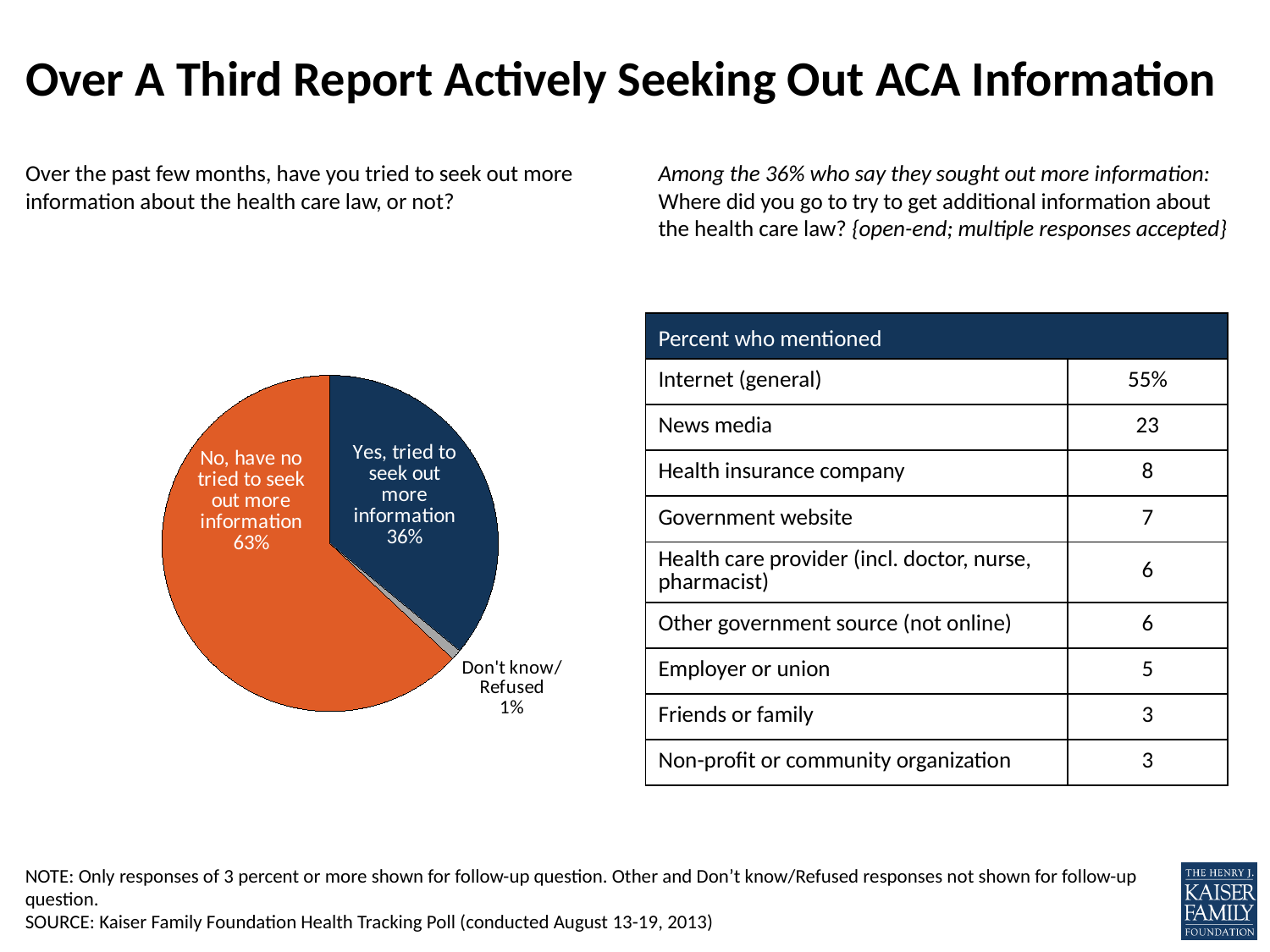
What colour is the "Yes, tried to seek out more information" slice? dark blue What colour is the "No, have no tried to seek out more information" slice? orange How many slices does the pie chart have? 3 What share of the pie is "Yes, tried to seek out more information"? 36% What is the difference in percentage points between the "No" slice and the "Yes" slice? 27 What is the combined share of the "Yes" and "No" slices in the pie chart? 99% What kind of chart is shown on the slide? pie chart Which slice of the pie chart is the smallest? Don't know/Refused Which is larger in the pie chart: the "Yes, tried to seek out more information" slice or the "No, have no tried to seek out more information" slice? No, have no tried to seek out more information Which slice of the pie chart is the largest? No, have no tried to seek out more information What share of the pie is "Don't know/Refused"? 1% What share of the pie is "No, have no tried to seek out more information"? 63%